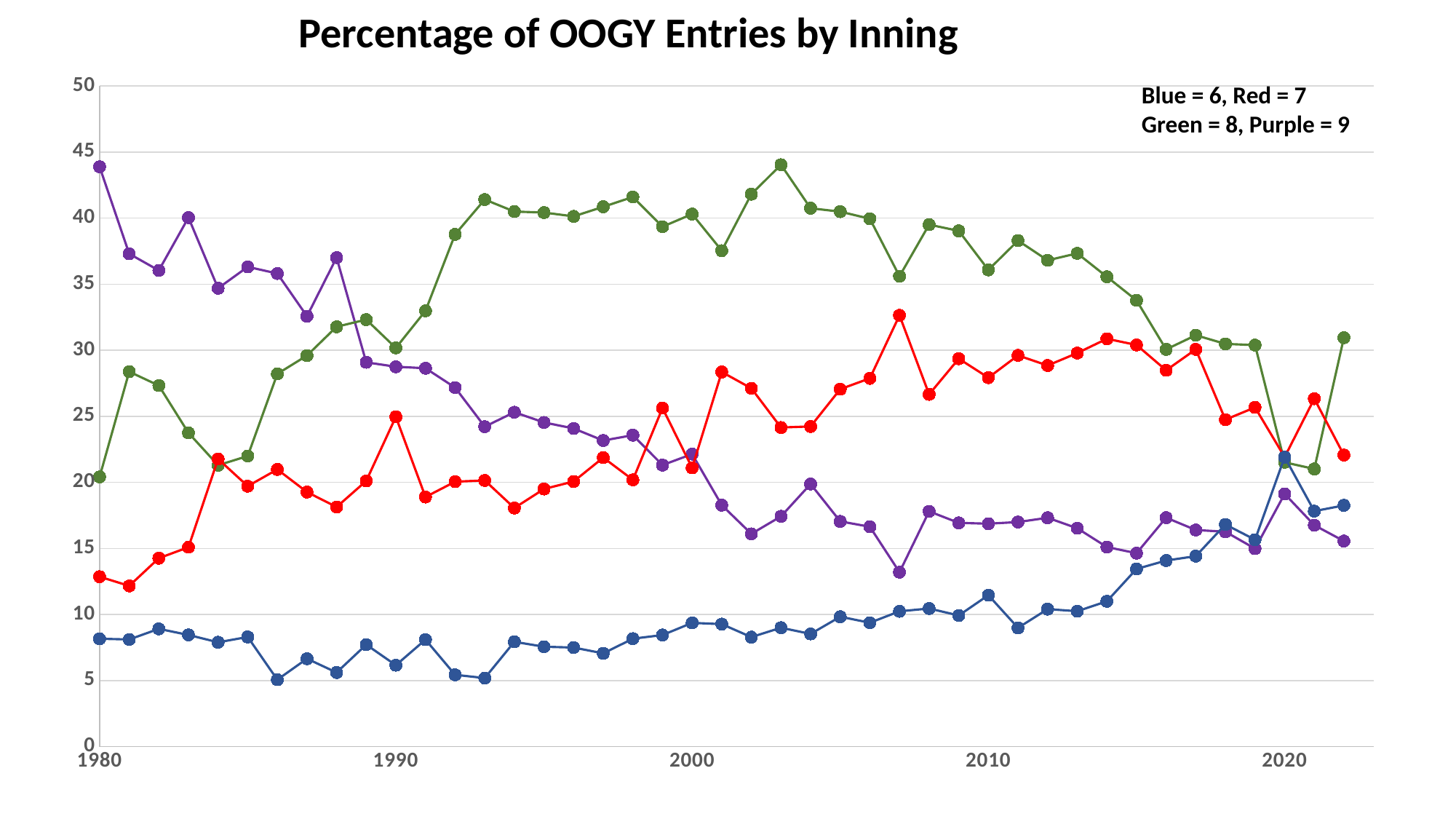
Is the value for the purple (inning 9) line in 1980 greater or less than 40? greater How many series does the chart's legend text list? 4 In 1980, which is larger: the purple (inning 9) value or the green (inning 8) value? purple (inning 9) Which series has the lowest value in 1990? Blue (inning 6) What kind of chart is shown on the slide? line chart Is the value for the blue (inning 6) line in 1980 greater or less than 10? less Is the value for the green (inning 8) line in 2003 greater or less than 40? greater According to the legend text, which colour represents inning 8? Green Does the purple (inning 9) line generally rise or fall from 1980 to 2022? fall What is the title of the chart? Percentage of OOGY Entries by Inning Which series has the highest value in 2010? Green (inning 8)